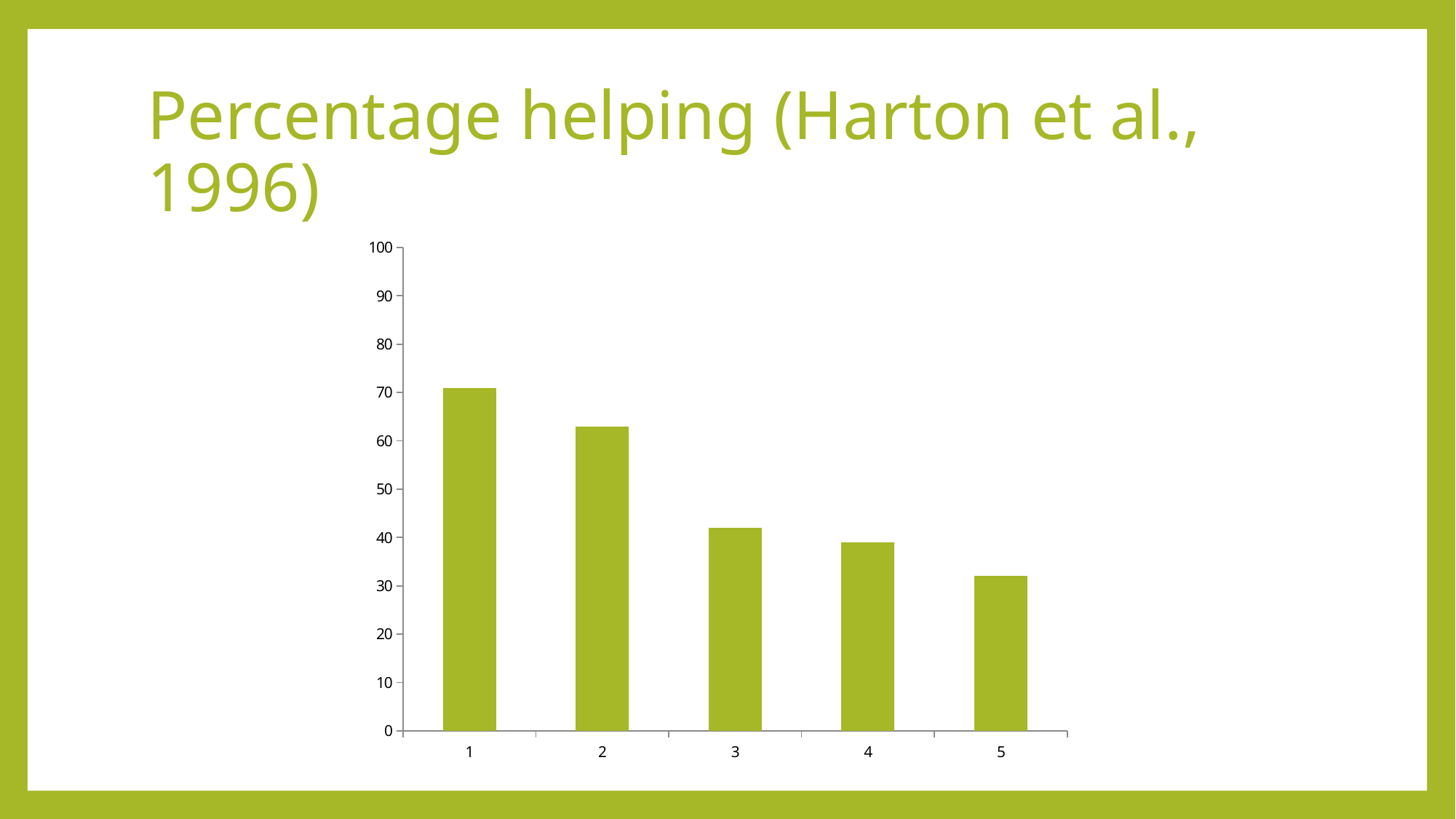
What kind of chart is shown on the slide? bar chart What is the title of the slide containing the chart? Percentage helping (Harton et al., 1996) Which category has the lowest bar? 5 Which category has the highest bar? 1 How many bars are plotted in the chart? 5 Is the value for category 4 greater or less than 50? less Is the value for category 2 greater or less than 50? greater Which is larger, the value for category 2 or the value for category 5? 2 Is the value for category 1 greater or less than 60? greater Do the values rise or fall from category 1 to category 5? fall